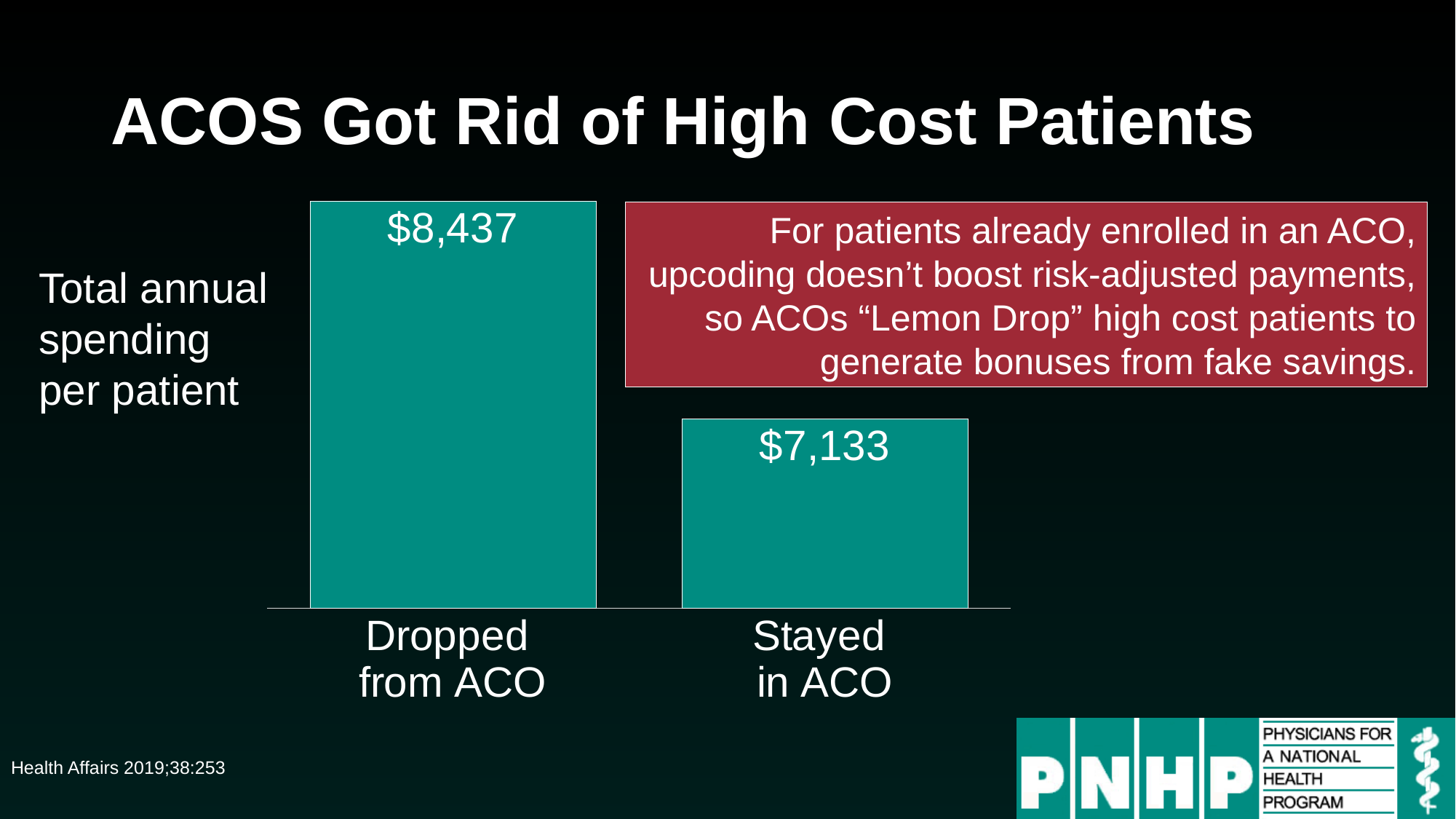
What quantity does the chart's axis label say the bars represent? Total annual spending per patient What is the total annual spending per patient for patients dropped from ACO? $8,437 Which category has the lower total annual spending per patient? Stayed in ACO Which category has the higher total annual spending per patient? Dropped from ACO What is the total annual spending per patient for patients who stayed in ACO? $7,133 What is the title of the slide containing the chart? ACOS Got Rid of High Cost Patients How many categories are shown in the bar chart? 2 What kind of chart is shown on the slide? Bar chart What is the difference in total annual spending per patient between patients dropped from ACO and patients who stayed in ACO? $1,304 Is the spending per patient larger for patients dropped from ACO or for patients who stayed in ACO? Dropped from ACO